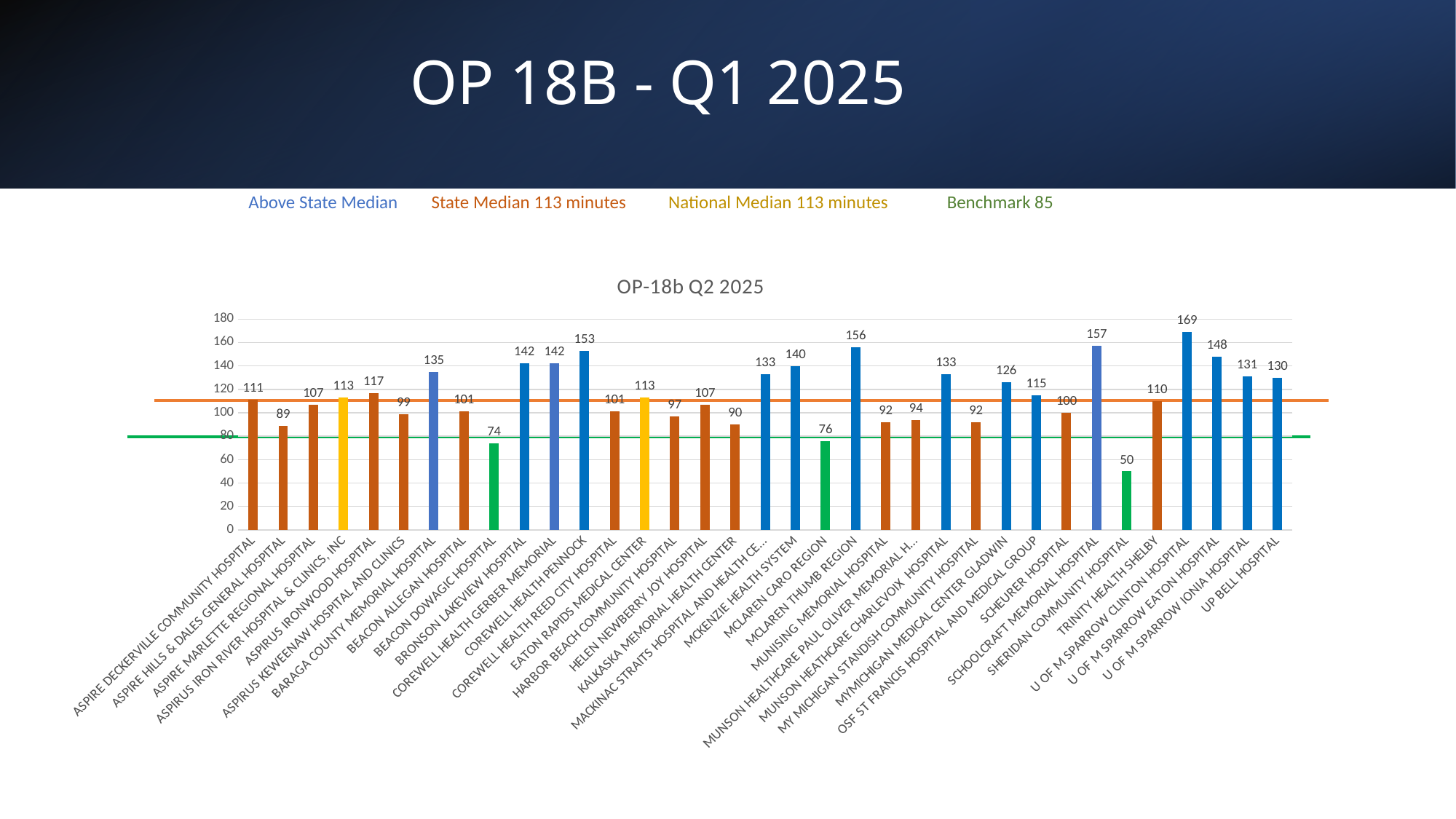
What is the difference between the values for COREWELL HEALTH PENNOCK and COREWELL HEALTH REED CITY HOSPITAL? 52 What kind of chart is this? Bar chart Which hospital has the highest value? U OF M SPARROW CLINTON HOSPITAL How many hospitals are shown on the chart? 35 What is the value for SCHEURER HOSPITAL? 100 What is the value for MCLAREN THUMB REGION? 156 According to the legend text above the chart, what is the State Median in minutes? 113 minutes Which is larger, the value for BARAGA COUNTY MEMORIAL HOSPITAL or the value for MYMICHIGAN MEDICAL CENTER GLADWIN? BARAGA COUNTY MEMORIAL HOSPITAL What is the value for BEACON DOWAGIC HOSPITAL? 74 What is the chart's title? OP-18b Q2 2025 Which hospital has the lowest value? SHERIDAN COMMUNITY HOSPITAL What is the value for U OF M SPARROW CLINTON HOSPITAL? 169